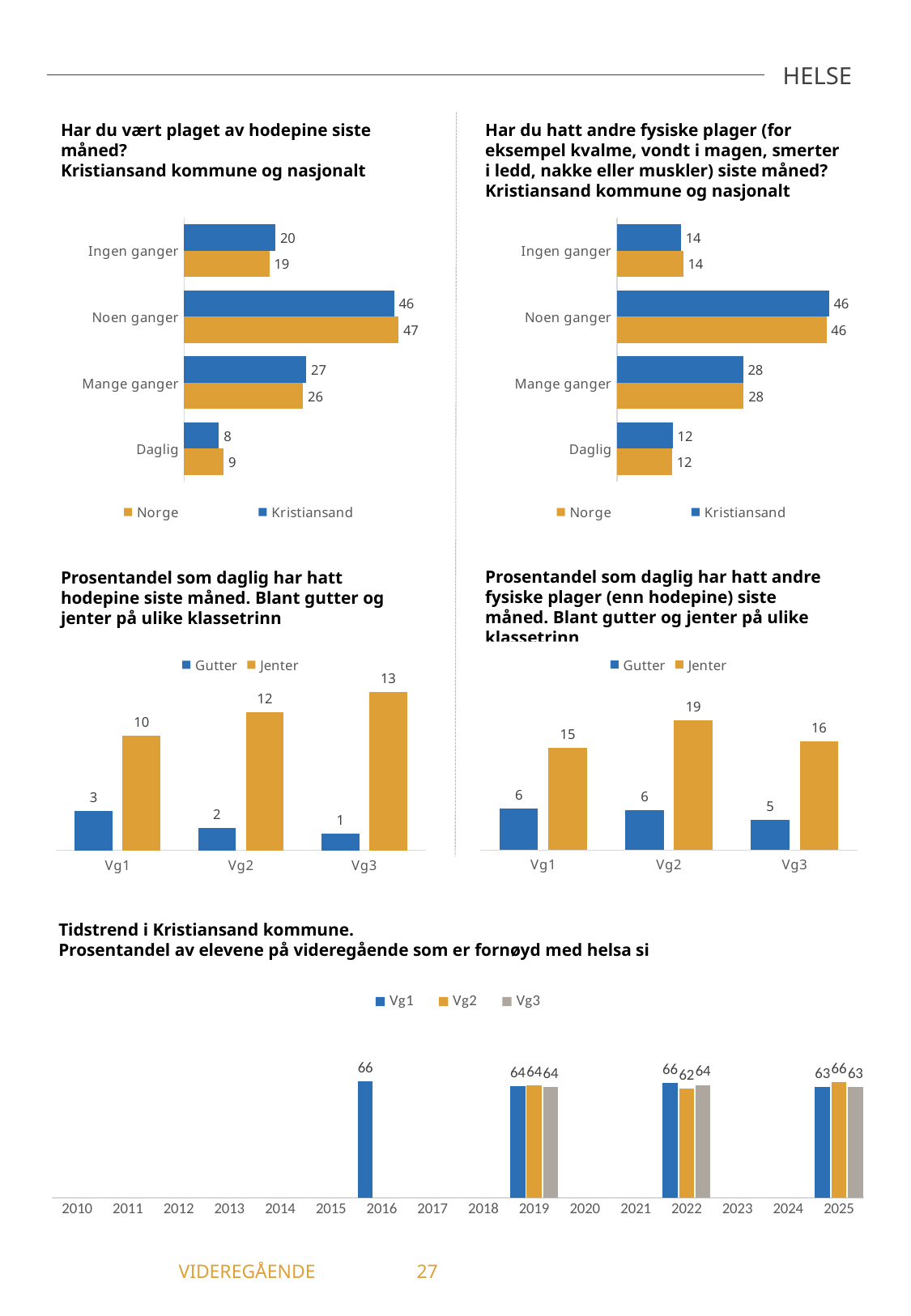
In the chart 'Har du hatt andre fysiske plager ... siste måned?', what is the value for Norge in the 'Mange ganger' category? 28 In the chart 'Har du hatt andre fysiske plager ... siste måned?', which category has the lowest value for Kristiansand? Daglig In the chart 'Har du vært plaget av hodepine siste måned?', what is the value for Kristiansand in the 'Noen ganger' category? 46 In the chart 'Har du vært plaget av hodepine siste måned?', which category has the highest value for Kristiansand? Noen ganger In the chart 'Prosentandel som daglig har hatt andre fysiske plager (enn hodepine) siste måned', which class level has the highest value for Jenter? Vg2 In the chart 'Prosentandel som daglig har hatt hodepine siste måned', what is the difference between Jenter and Gutter at Vg1? 7 What kind of chart is the 'Tidstrend i Kristiansand kommune' chart at the bottom of the slide? bar chart In the chart 'Har du hatt andre fysiske plager ... siste måned?', how many series does the legend list? 2 In the chart 'Tidstrend i Kristiansand kommune', what is the value for Vg2 in 2022? 62 In the chart 'Prosentandel som daglig har hatt hodepine siste måned', what is the value for Jenter at Vg3? 13 In the chart 'Har du vært plaget av hodepine siste måned?', what is the value for Norge in the 'Daglig' category? 9 In the chart 'Prosentandel som daglig har hatt hodepine siste måned', do the Gutter values rise or fall from Vg1 to Vg3? fall